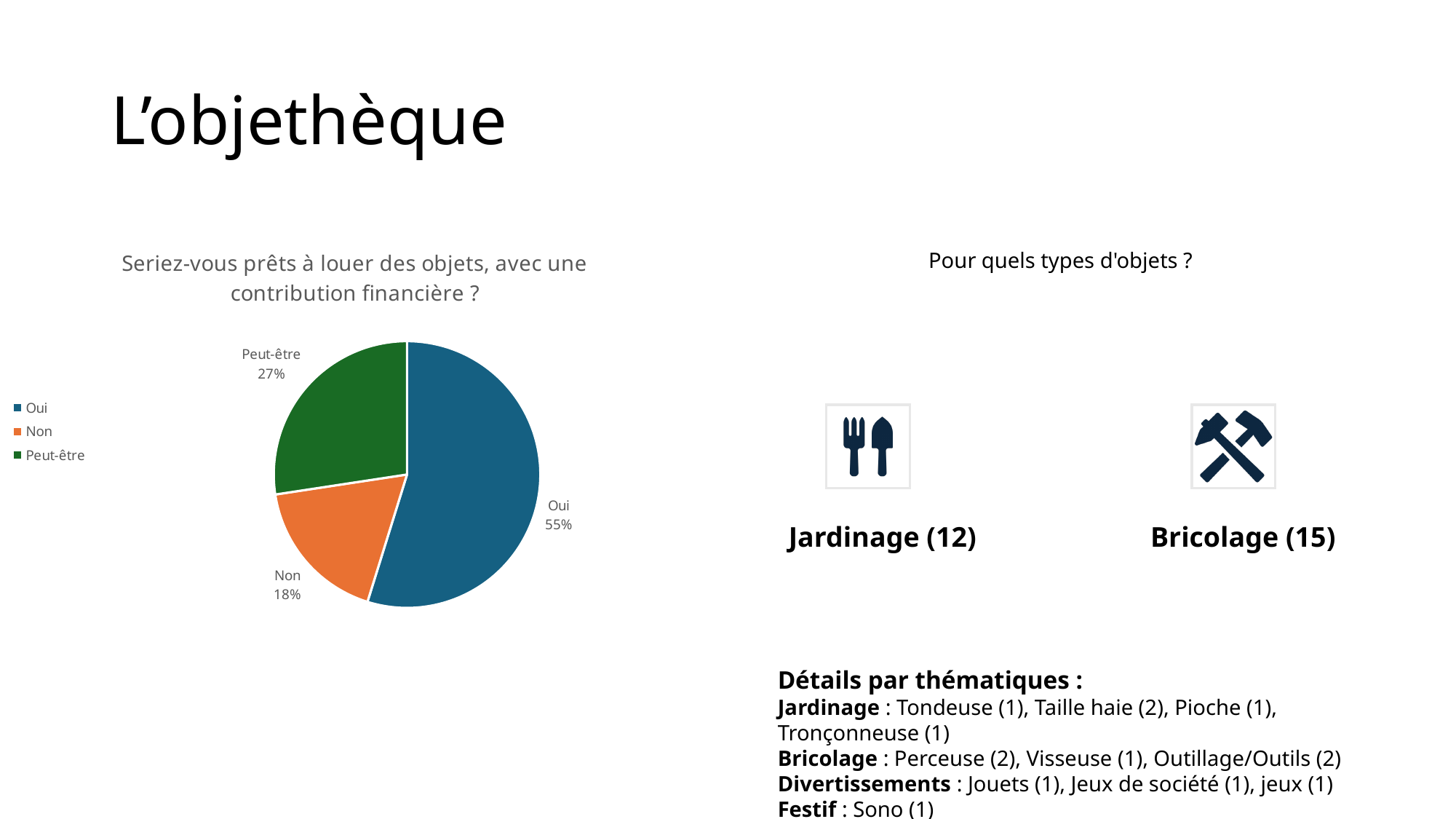
Which slice is larger, "Peut-être" or "Non"? Peut-être How many slices does the pie chart have? 3 Which category has the largest slice of the pie? Oui What share of the pie does "Peut-être" represent? 27% What is the difference in percentage points between the "Oui" and "Non" slices? 37 What is the title of the pie chart? Seriez-vous prêts à louer des objets, avec une contribution financière ? What kind of chart is shown on the slide? Pie chart What share of the pie does "Non" represent? 18% What is the difference in percentage points between the "Peut-être" and "Non" slices? 9 Which category has the smallest slice of the pie? Non What colour is the "Non" slice in the pie chart? Orange What share of the pie does "Oui" represent? 55%